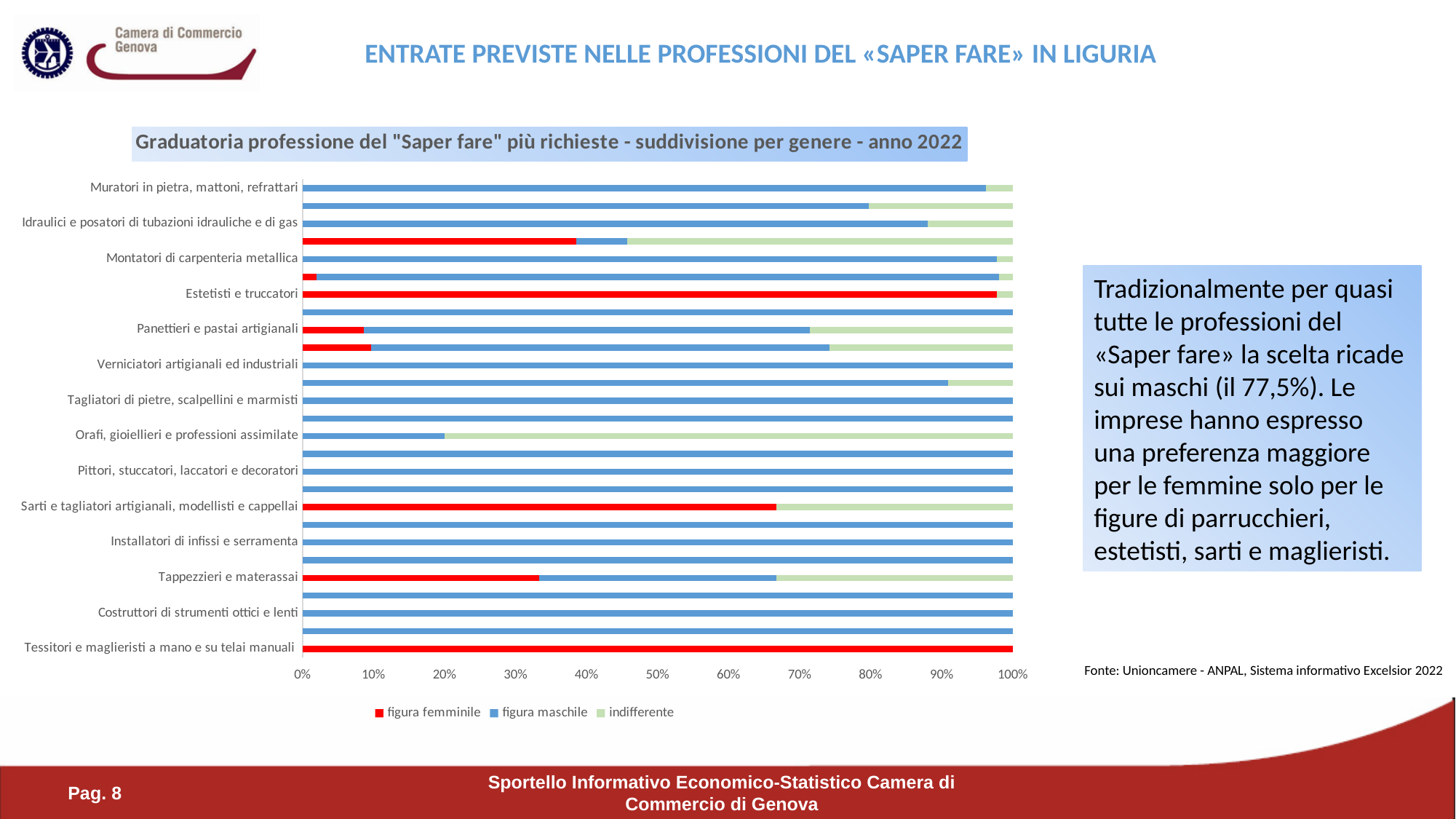
What kind of chart is shown on the slide? Stacked bar chart Is the 'figura maschile' share for 'Orafi, gioiellieri e professioni assimilate' greater or less than 30%? less Is the 'figura femminile' share for 'Sarti e tagliatori artigianali, modellisti e cappellai' greater or less than 60%? greater What are the three series named in the legend? figura femminile, figura maschile, indifferente What is the title of the chart? Graduatoria professione del "Saper fare" più richieste - suddivisione per genere - anno 2022 Which has a larger 'figura femminile' share: 'Estetisti e truccatori' or 'Sarti e tagliatori artigianali, modellisti e cappellai'? Estetisti e truccatori Which has a larger 'figura maschile' share: 'Orafi, gioiellieri e professioni assimilate' or 'Muratori in pietra, mattoni, refrattari'? Muratori in pietra, mattoni, refrattari Is the 'figura femminile' share for 'Tappezzieri e materassai' greater or less than 40%? less Which series makes up the entire bar for 'Tessitori e maglieristi a mano e su telai manuali'? figura femminile How many series does the legend list? 3